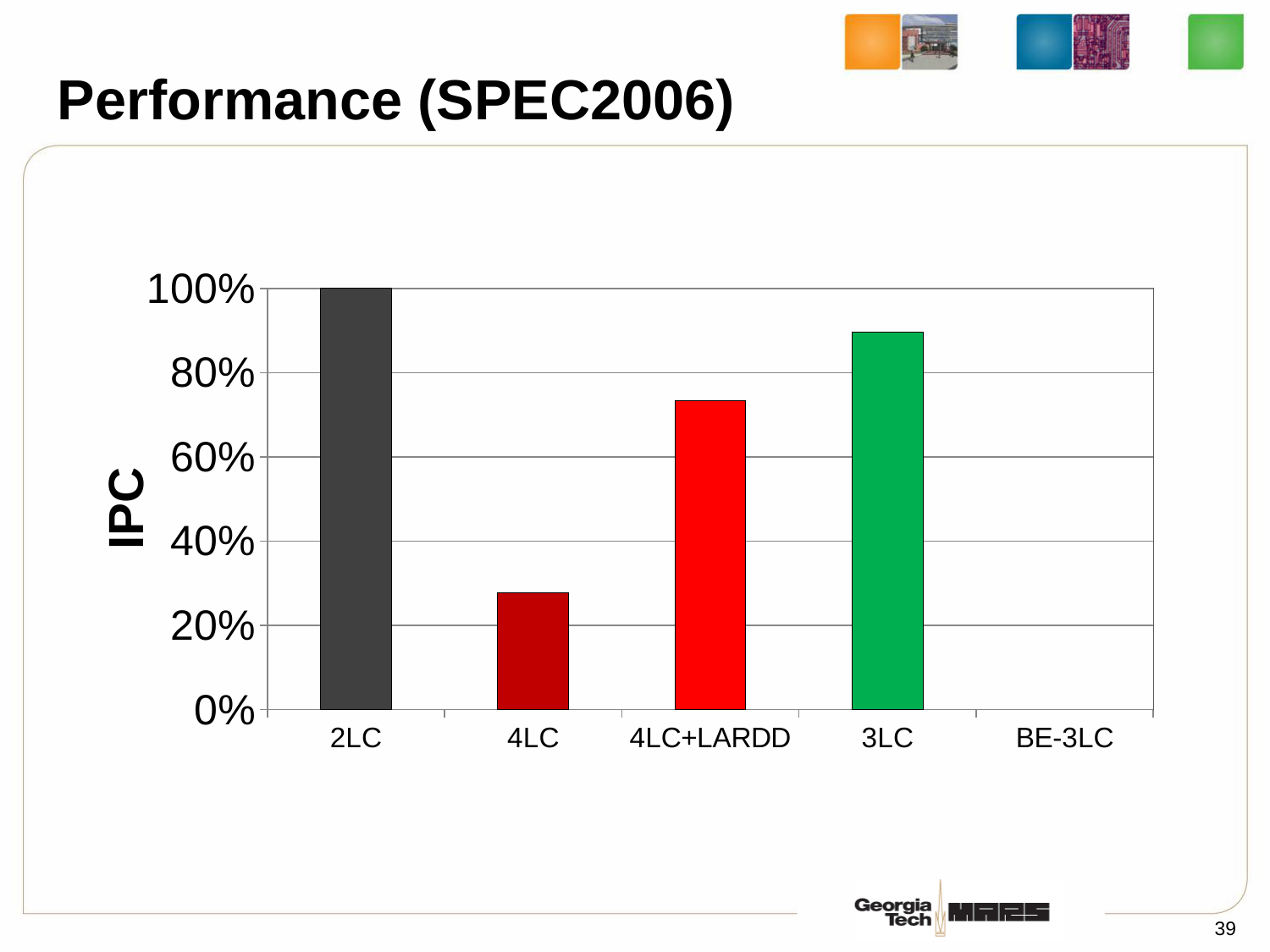
Which has a higher IPC, 3LC or 4LC+LARDD? 3LC Which category has the highest IPC? 2LC What colour is the bar for 3LC? green How many categories are listed on the x axis? 5 Among the plotted bars, which category has the lowest IPC? 4LC Is the IPC value for 3LC greater or less than 80%? greater Is the IPC value for 4LC greater or less than 20%? greater Is the IPC value for 4LC+LARDD greater or less than 60%? greater What is the IPC value for 2LC? 100% What is the label on the y axis? IPC What type of chart is shown on the slide? bar chart